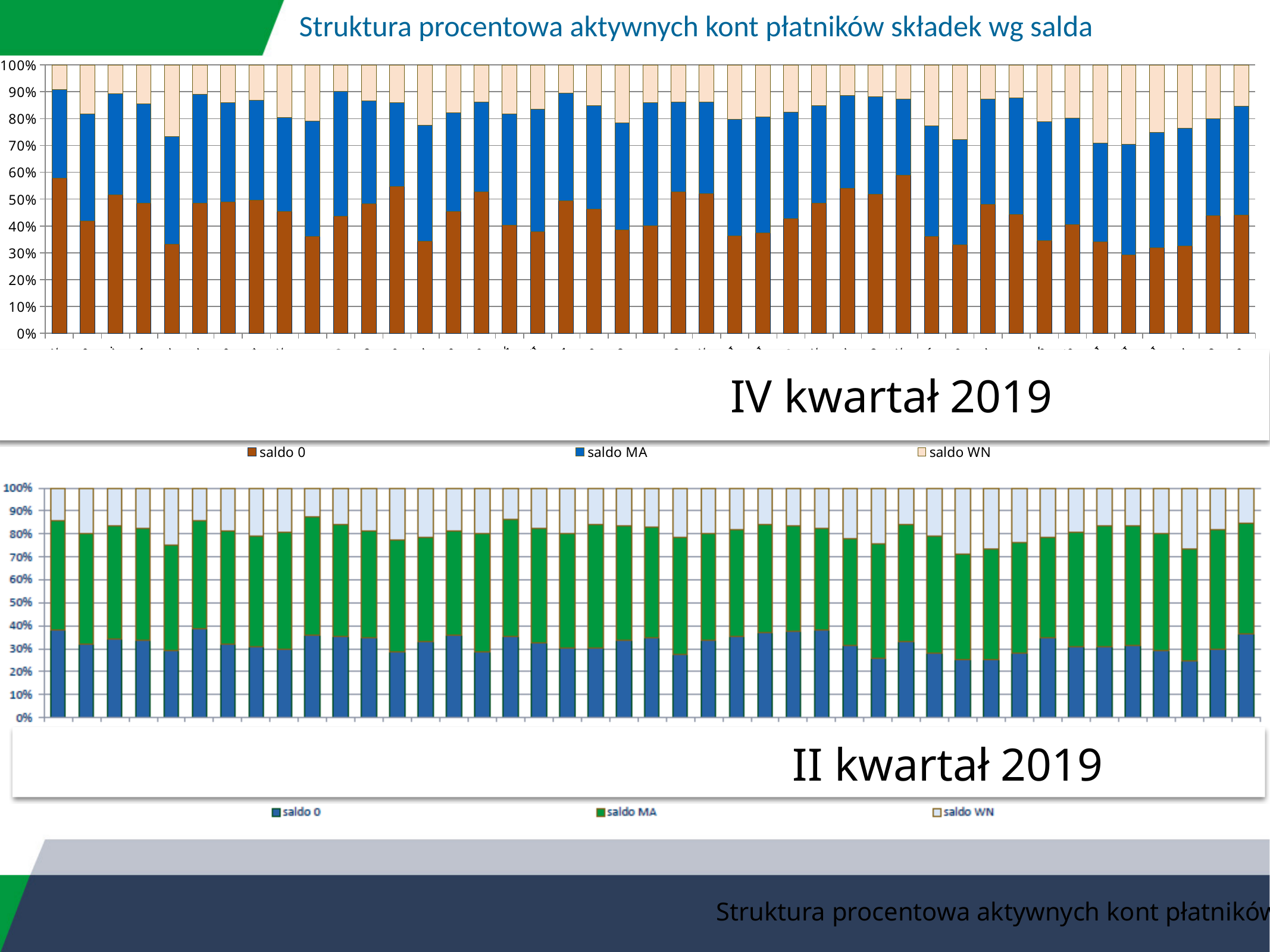
In the bottom chart (II kwartał 2019), is the saldo 0 segment of the first bar greater or less than 50%? less What kind of chart is the top chart labelled IV kwartał 2019? stacked bar chart In the top chart (IV kwartał 2019), is the saldo 0 segment of the fifth bar greater or less than 40%? less What are the legend entries of the bottom chart (II kwartał 2019)? saldo 0, saldo MA, saldo WN What is the title shown above the top chart? Struktura procentowa aktywnych kont płatników składek wg salda What kind of chart is the bottom chart labelled II kwartał 2019? stacked bar chart What is the highest value shown on the vertical axis of the bottom chart (II kwartał 2019)? 100% How many series does the legend of the bottom chart (II kwartał 2019) list? 3 In the top chart (IV kwartał 2019), is the saldo 0 segment of the first bar greater or less than 50%? greater How many series does the legend of the top chart (IV kwartał 2019) list? 3 In the top chart (IV kwartał 2019), what do the three segments of each stacked bar add up to? 100%